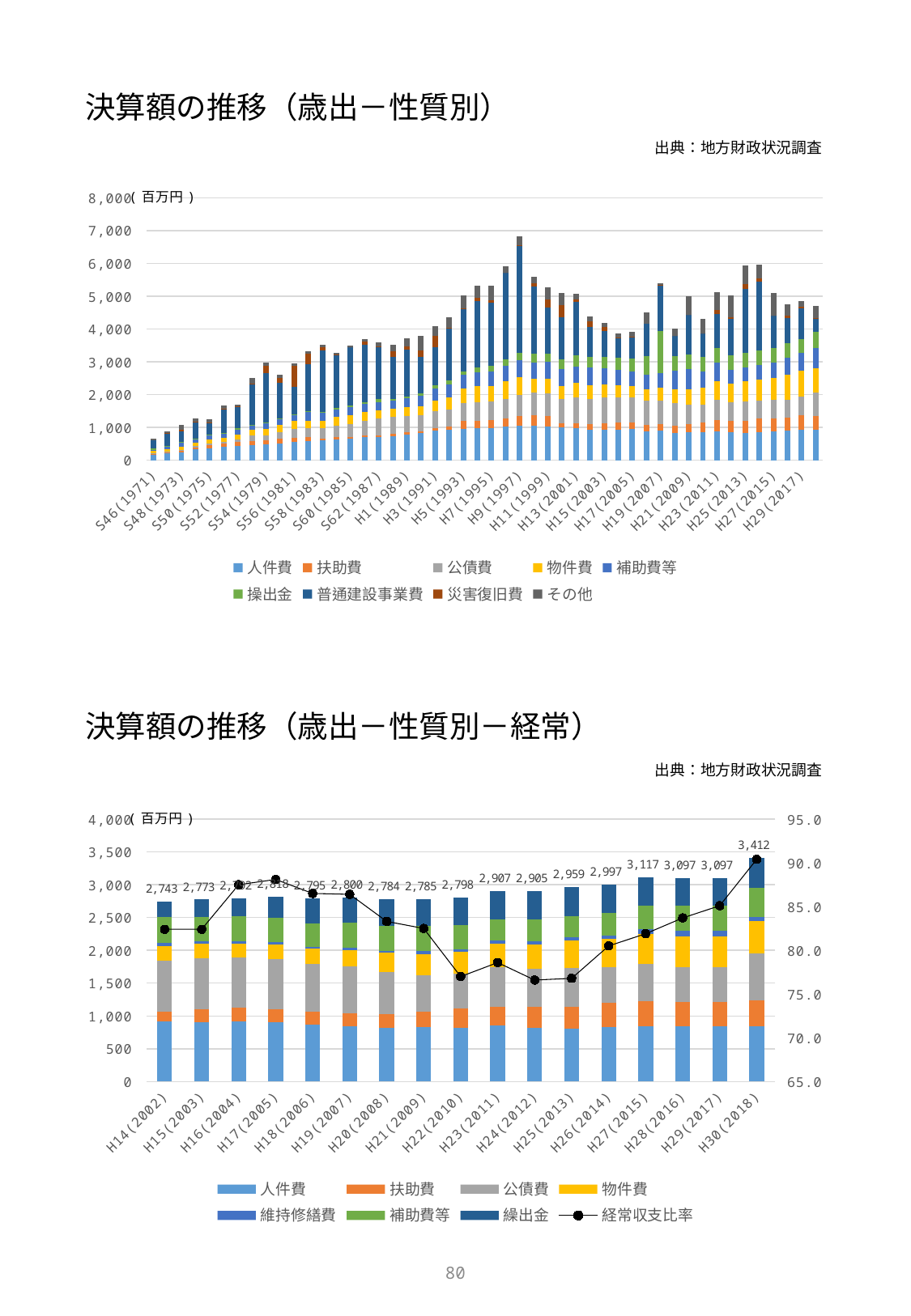
In the top chart (決算額の推移（歳出－性質別）), is the total bar height for H9(1997) greater or less than 6,000? greater In the bottom chart (決算額の推移（歳出－性質別－経常）), what is the total value labelled for H30(2018)? 3,412 What kind of chart is the top chart (決算額の推移（歳出－性質別）)? Stacked bar chart How many entries does the legend of the top chart (決算額の推移（歳出－性質別）) list? 9 In the bottom chart (決算額の推移（歳出－性質別－経常）), what is the difference between the labelled totals for H30(2018) and H29(2017)? 315 In the bottom chart (決算額の推移（歳出－性質別－経常）), what is the total value labelled for H17(2005)? 2,818 How many entries does the legend of the bottom chart (決算額の推移（歳出－性質別－経常）) list? 8 In the bottom chart (決算額の推移（歳出－性質別－経常）), which year has the highest labelled total? H30(2018) How many years (bars) are shown on the x axis of the bottom chart (決算額の推移（歳出－性質別－経常）)? 17 In the bottom chart (決算額の推移（歳出－性質別－経常）), does the 経常収支比率 line rise or fall from H24(2012) to H30(2018)? rise In the bottom chart (決算額の推移（歳出－性質別－経常）), which has the larger labelled total, H26(2014) or H27(2015)? H27(2015) In the bottom chart (決算額の推移（歳出－性質別－経常）), which year has the lowest labelled total? H14(2002)